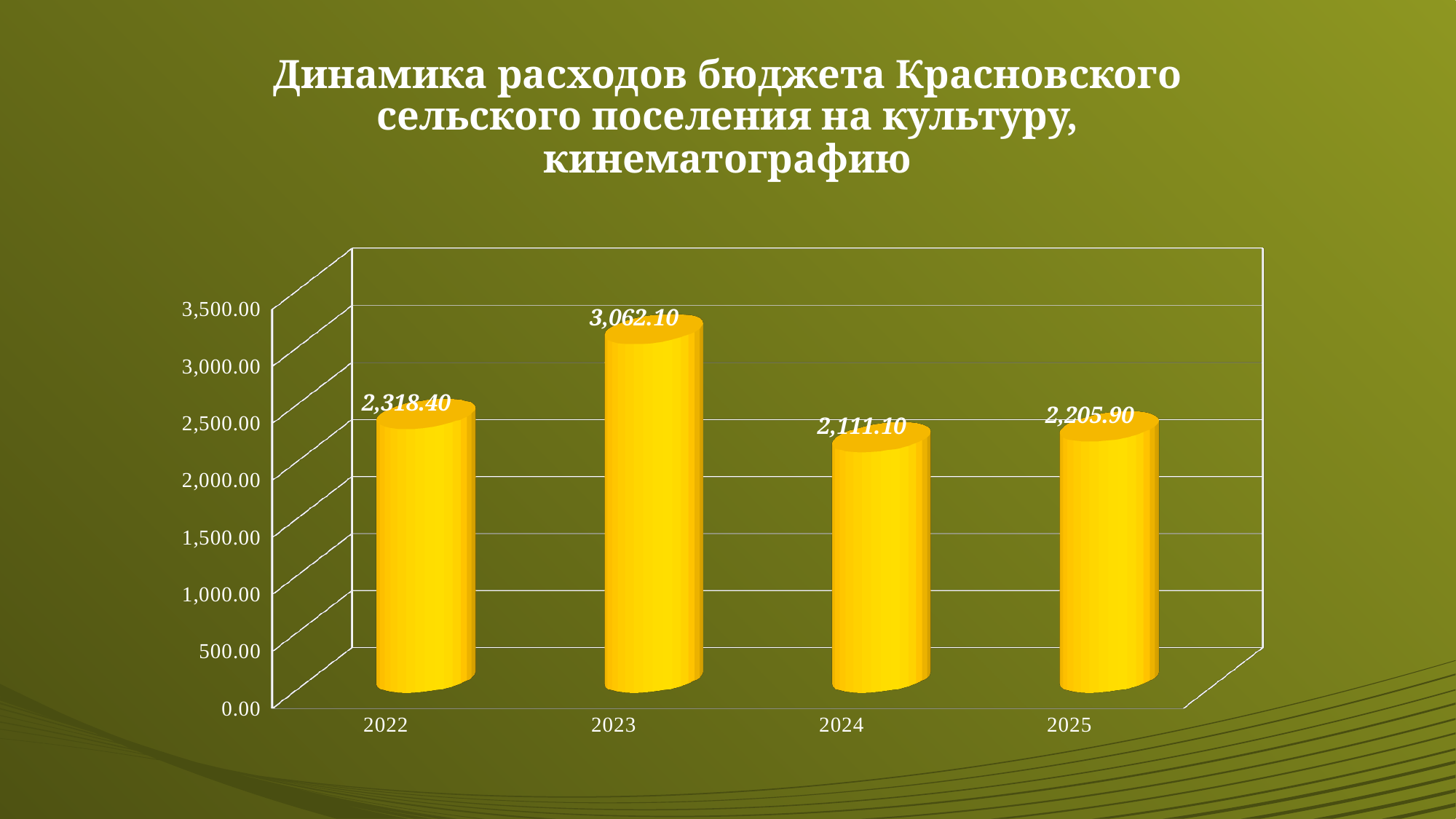
What kind of chart is shown on the slide? bar chart What is the value for 2024? 2,111.10 Which is larger, the value for 2022 or the value for 2025? 2022 What is the value for 2025? 2,205.90 Which year has the highest value? 2023 What is the difference between the values for 2025 and 2024? 94.80 What is the value for 2022? 2,318.40 Which year has the lowest value? 2024 What is the value for 2023? 3,062.10 Is the value for 2023 greater or less than 3,000.00? greater What is the difference between the values for 2023 and 2022? 743.70 How many years are shown on the chart? 4